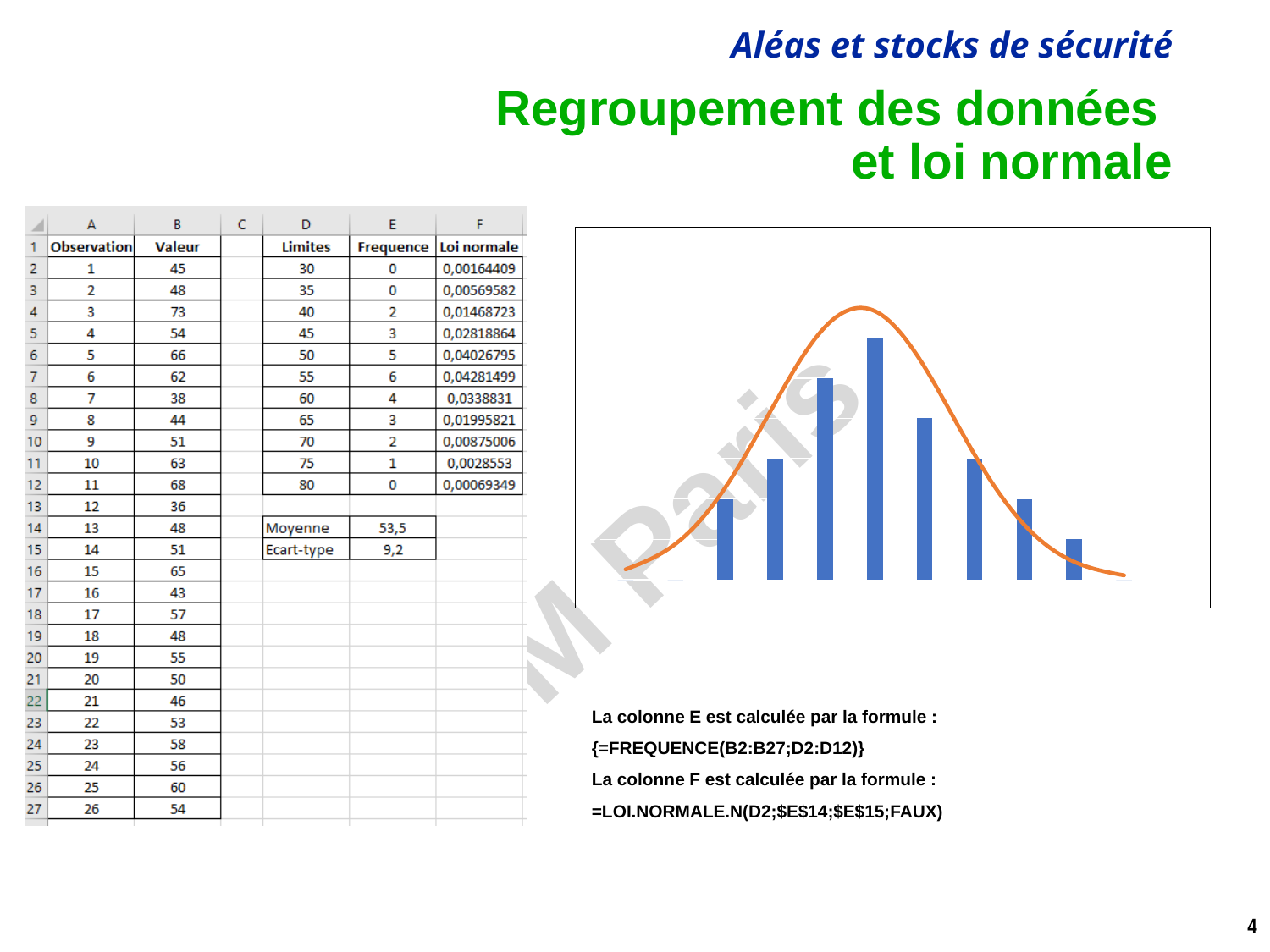
How many bars are visible in the chart? 8 What colour is the curve drawn over the bars in the chart? orange Is the fifth bar from the left taller or shorter than the fourth bar from the left? shorter Do the bar heights rise or fall from the leftmost bar to the fourth bar? rise Is the seventh bar from the left taller or shorter than the sixth bar from the left? shorter Which bar is the shortest in the chart, counting from the left? the eighth (rightmost) bar What kind of chart is shown on the right of the slide? bar chart with a line curve Which bar is the tallest in the chart, counting from the left? the fourth bar Is the third bar from the left taller or shorter than the second bar from the left? taller Do the bar heights rise or fall from the fourth bar to the rightmost bar? fall What colour are the bars in the chart? blue